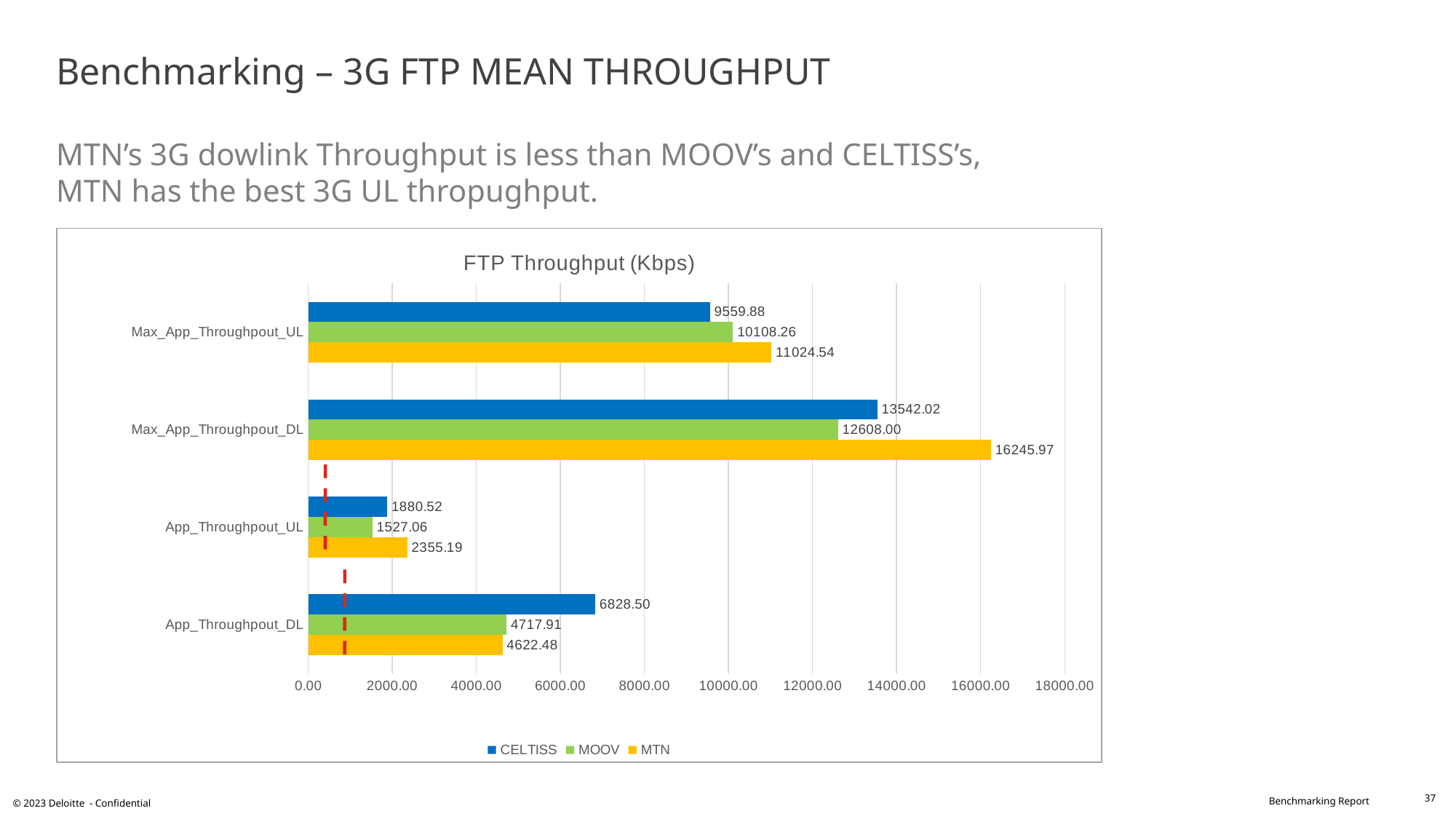
What is the MOOV value for App_Throughpout_UL? 1527.06 What is the title of the chart? FTP Throughput (Kbps) Which series is shown in yellow in the legend? MTN What type of chart is shown on the slide? Bar chart Which operator has the highest value for Max_App_Throughpout_UL? MTN What is the MTN value for Max_App_Throughpout_DL? 16245.97 What is the difference between the MTN and CELTISS values for Max_App_Throughpout_DL? 2703.95 Which operator has the lowest value for App_Throughpout_DL? MTN For App_Throughpout_UL, which is larger: the CELTISS value or the MTN value? MTN How many categories are shown on the chart? 4 How many series does the legend list? 3 What is the CELTISS value for App_Throughpout_DL? 6828.50